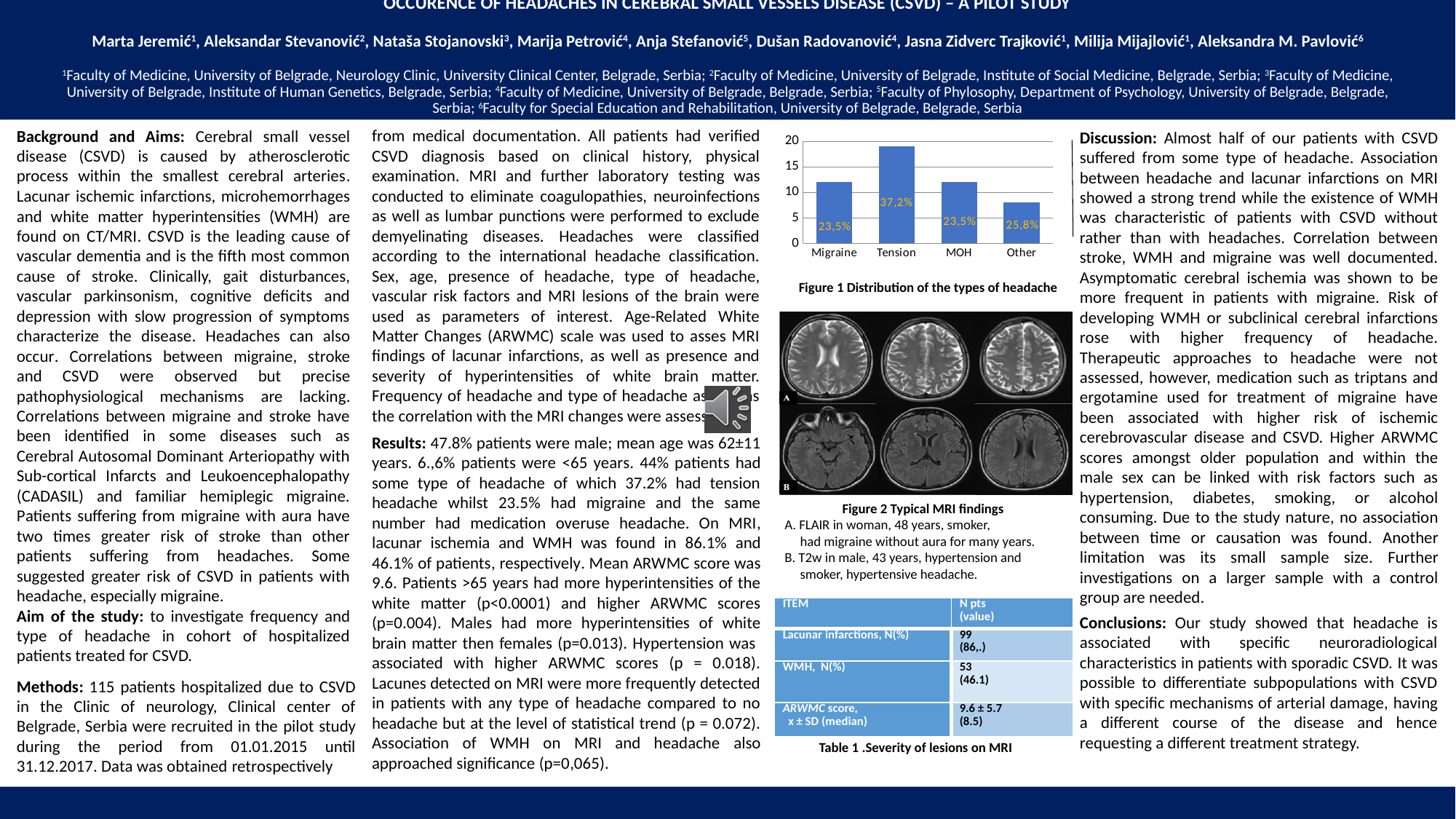
What is the data label shown on the Tension bar in the Figure 1 chart? 37,2% Which headache type has the tallest bar in the Figure 1 chart? Tension What kind of chart is shown in Figure 1? bar chart What is the data label shown on the Other bar in the Figure 1 chart? 25,8% How many headache types are shown on the x axis of the Figure 1 chart? 4 What is the data label shown on the MOH bar in the Figure 1 chart? 23,5% In the Figure 1 chart, is the height of the Tension bar greater or less than 15 on the y axis? greater What is the difference between the data labels on the Tension and Migraine bars in the Figure 1 chart? 13,7% In the Figure 1 chart, which bar is taller: Tension or Other? Tension What is the caption of the bar chart on the slide? Figure 1 Distribution of the types of headache What is the data label shown on the Migraine bar in the Figure 1 chart? 23,5% In the Figure 1 chart, is the height of the Other bar greater or less than 10 on the y axis? less